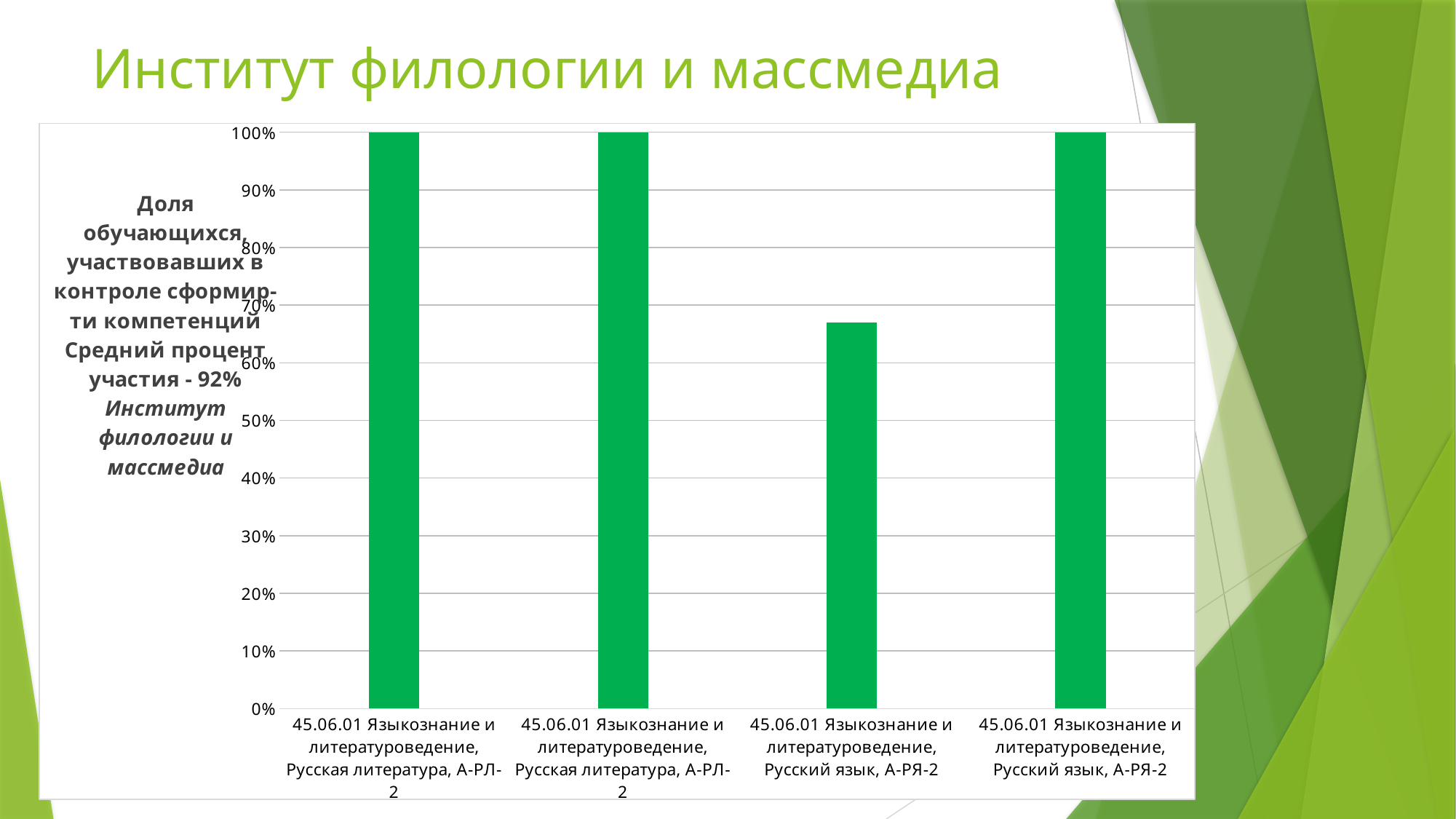
Which is larger: the second bar from the left or the third bar from the left? the second bar Which bar has the lowest value? the third bar from the left (45.06.01 Языкознание и литературоведение, Русский язык, А-РЯ-2) What is the value of the second bar from the left? 100% How many bars reach 100%? 3 How many bars are plotted in the chart? 4 What is the value of the fourth bar from the left (45.06.01 Языкознание и литературоведение, Русский язык, А-РЯ-2)? 100% What average participation percentage (Средний процент участия) is stated in the chart title? 92% What colour are the bars in the chart? green What is the value of the first bar from the left (45.06.01 Языкознание и литературоведение, Русская литература, А-РЛ-2)? 100% What kind of chart is shown on the slide? bar chart Is the value of the third bar from the left greater or less than 70%? less Is the value of the third bar from the left greater or less than 60%? greater